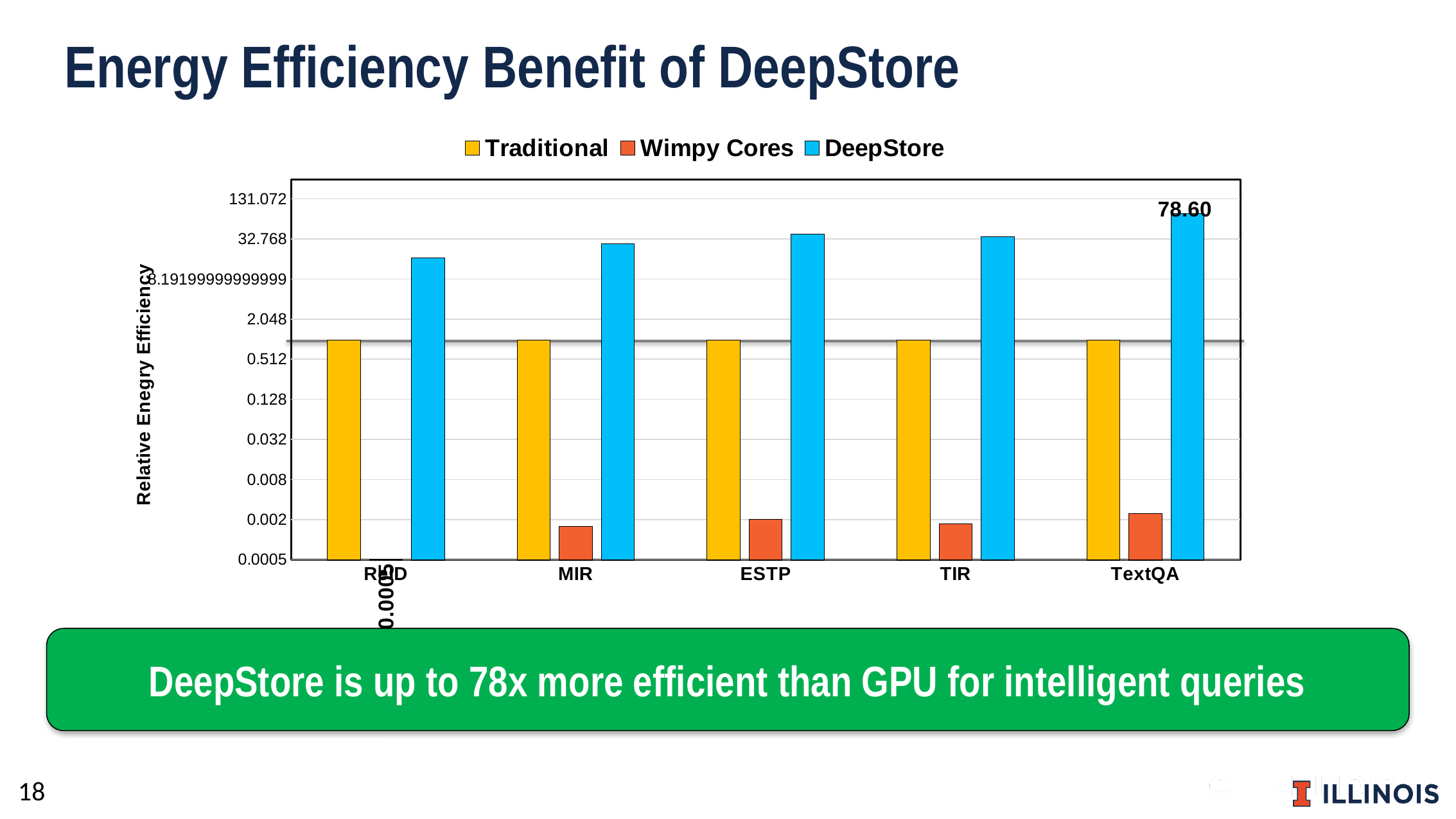
What is the DeepStore value for TextQA? 78.60 For MIR, which is larger: the Traditional value or the DeepStore value? DeepStore How many series does the legend list? 3 What is the title of the y axis? Relative Enegry Efficiency Is the DeepStore value for TextQA greater or less than 32.768? greater Is the Traditional value for ESTP greater or less than 2.048? less Is the Wimpy Cores value for MIR greater or less than 0.002? less Which category has the highest DeepStore value? TextQA Which category has the lowest Wimpy Cores value? ReID Which category has the lowest DeepStore value? ReID What kind of chart is shown on the slide? bar chart How many categories are shown on the x axis? 5